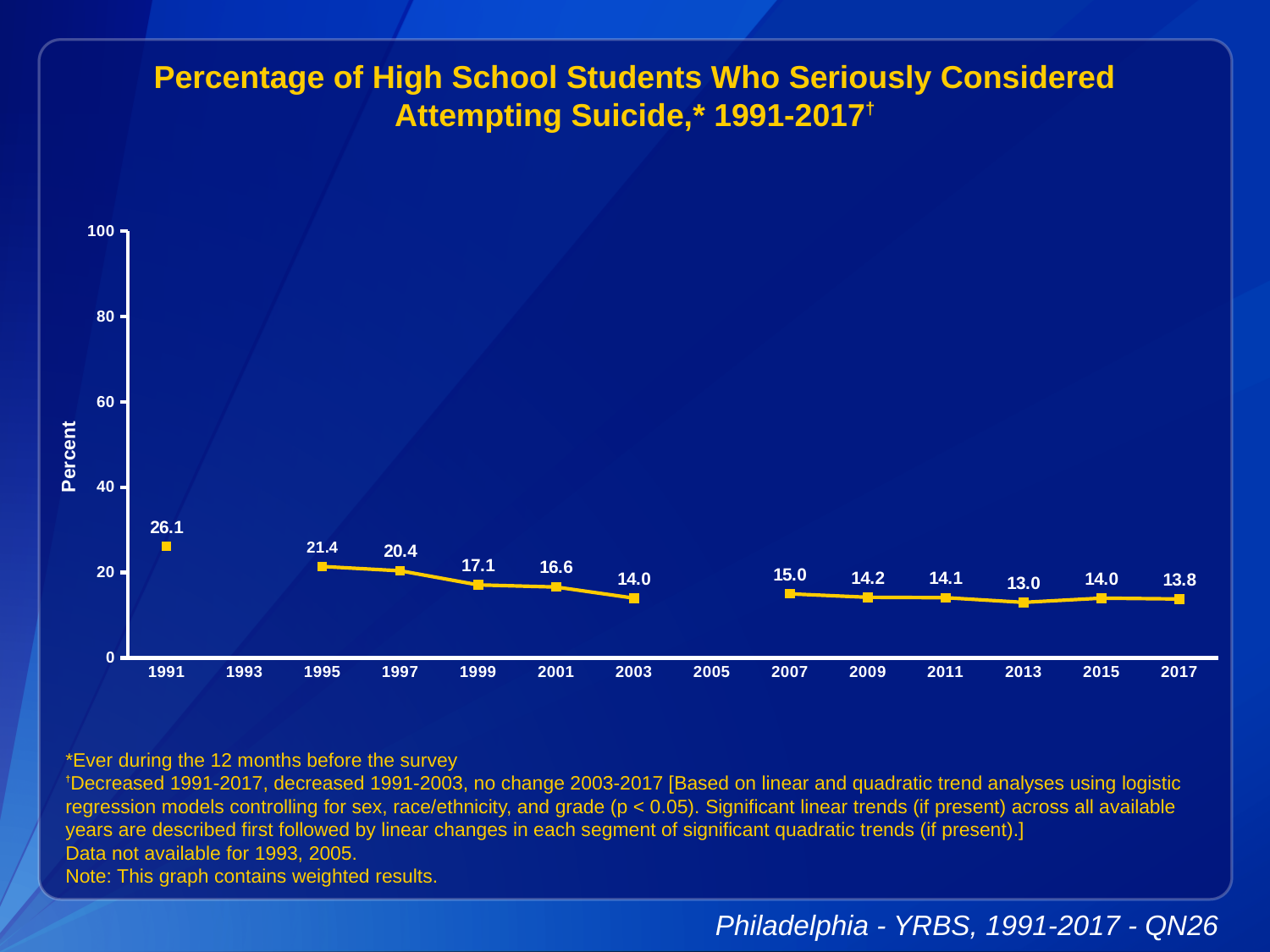
What is the difference between the 1991 value and the 2017 value? 12.3 What was the percentage of high school students who seriously considered attempting suicide in 1991? 26.1 Which year has the lowest percentage? 2013 Do the values generally rise or fall from 1991 to 2003? Fall Which year has the highest percentage? 1991 What value is shown for 2017? 13.8 Is the value for 1991 greater or less than 20? greater Which is larger, the value for 1999 or the value for 2009? 1999 What kind of chart is shown on the slide? Line chart What is the difference between the 1995 value and the 2003 value? 7.4 How many years have a plotted data point on the chart? 12 What value is shown for 2007? 15.0